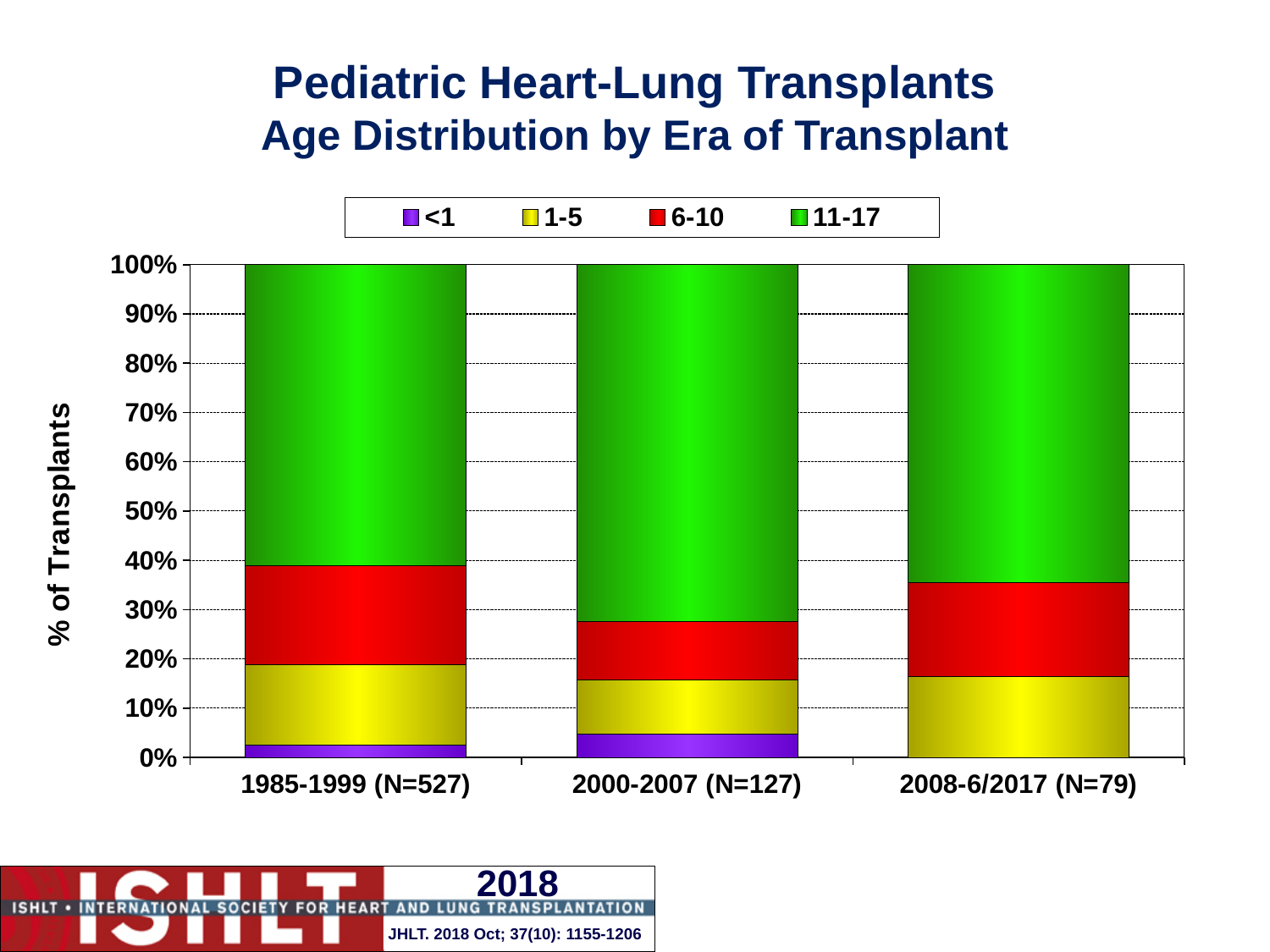
Which era has the largest share of transplants in the 11-17 age group? 2000-2007 (N=127) Is the share of the 6-10 age group in the 2000-2007 era greater or less than 20%? less Is the share of the 11-17 age group in the 1985-1999 era greater or less than 50%? greater What are the four age groups listed in the legend? <1, 1-5, 6-10, 11-17 Which era has the smallest share of transplants in the <1 age group? 2008-6/2017 (N=79) Is the share of the 6-10 age group in the 1985-1999 era greater or less than 10%? greater What type of chart is shown on the slide? Stacked bar chart Is the share of the <1 age group larger in the 1985-1999 era or the 2000-2007 era? 2000-2007 How many age groups does the legend list? 4 How many transplant eras are shown on the x axis? 3 What is the N shown for the 1985-1999 era? 527